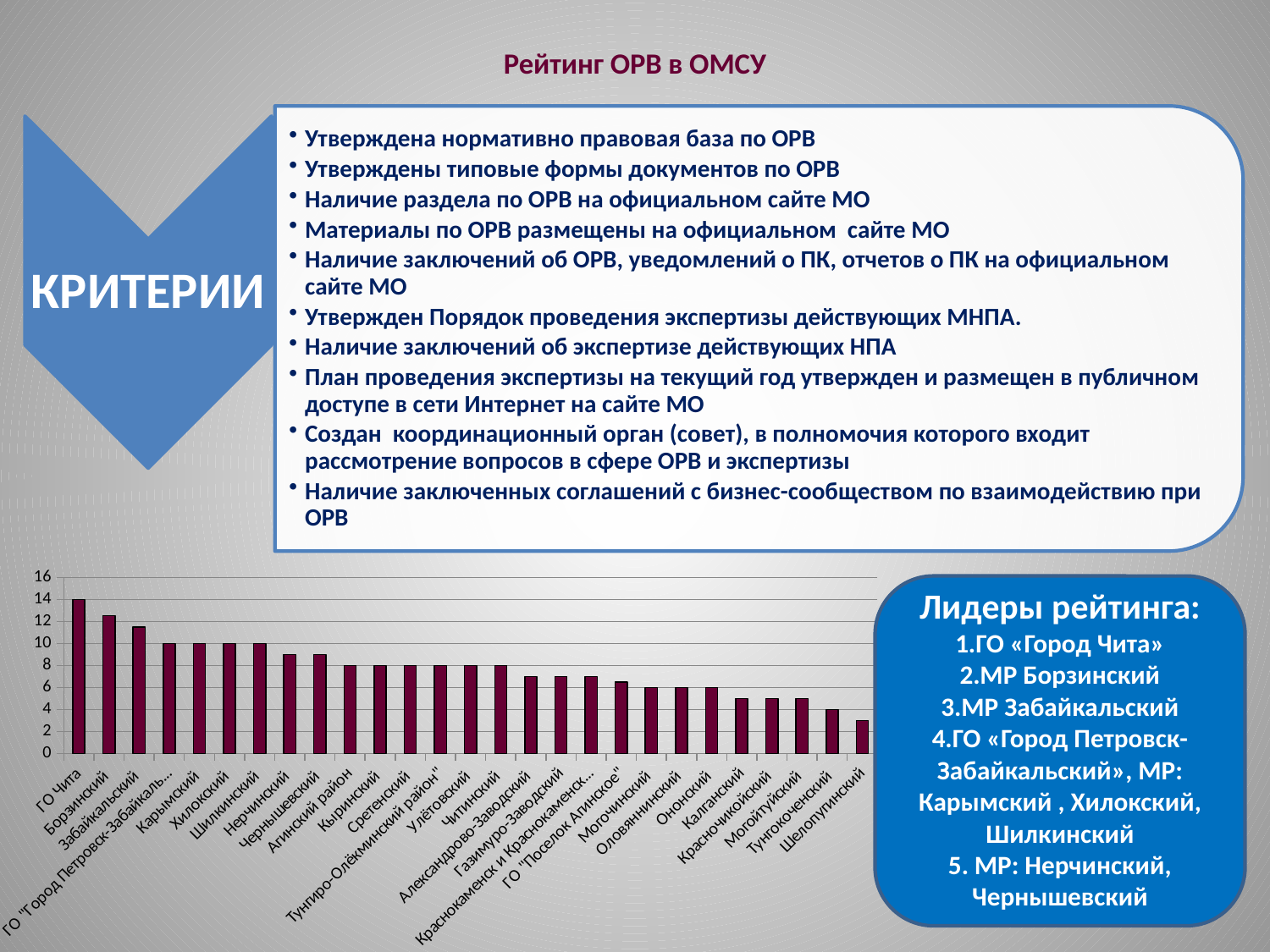
Which has a larger value, Борзинский or Шелопугинский? Борзинский Is the value for Забайкальский greater or less than 10? greater Is the value for Нерчинский greater or less than 8? greater What is the highest value shown on the vertical axis of the chart? 16 Is the value for Борзинский greater or less than 12? greater Which has a larger value, Тунгокоченский or Карымский? Карымский What kind of chart is shown at the bottom of the slide? bar chart Which category has the lowest bar in the chart? Шелопугинский Which category has the highest bar in the chart? ГО Чита Do the bar values rise or fall from left to right along the x axis? fall